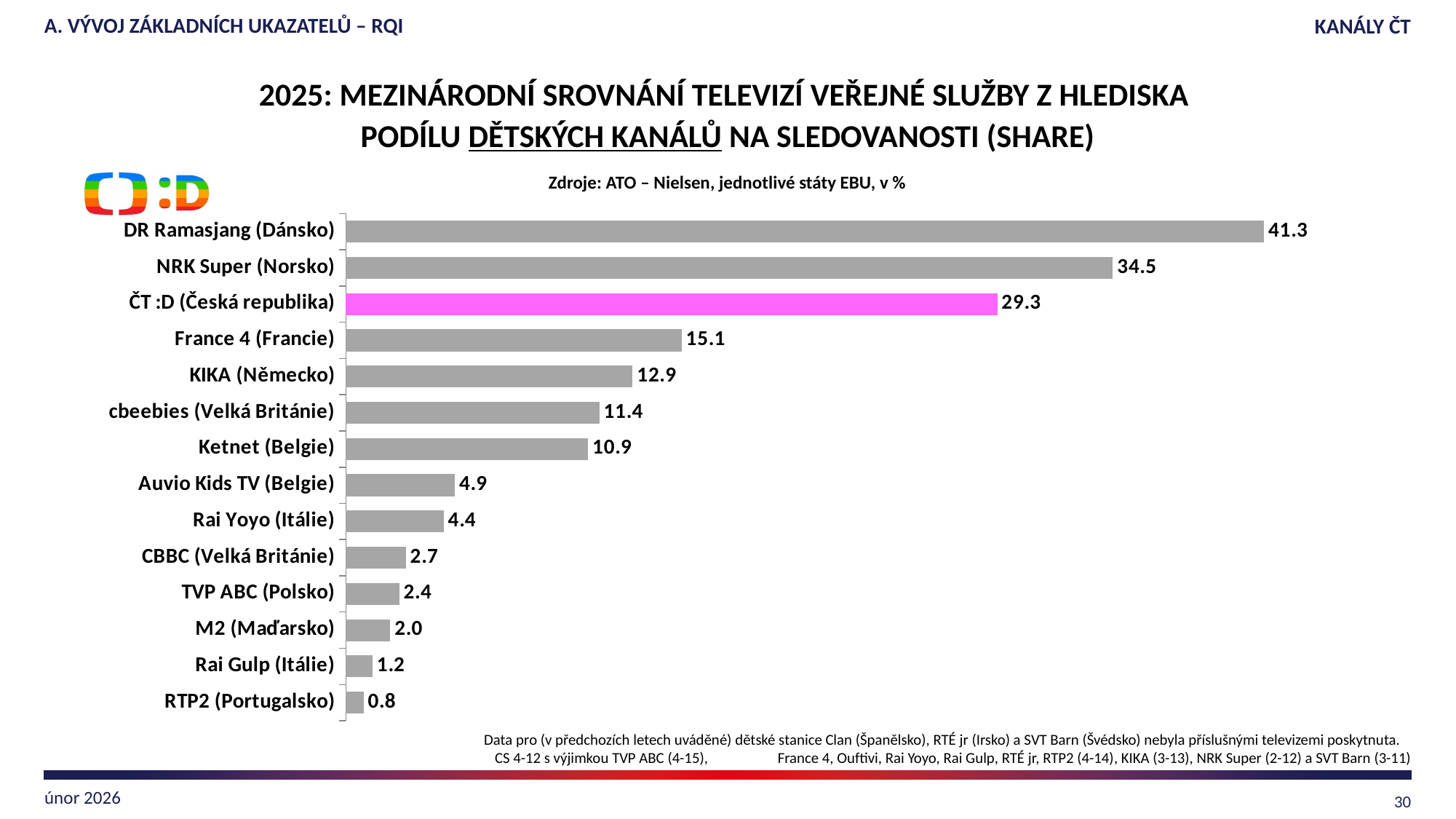
How many channels are shown in the chart? 14 What is the difference between the values for DR Ramasjang (Dánsko) and NRK Super (Norsko)? 6.8 Which has a larger value, TVP ABC (Polsko) or M2 (Maďarsko)? TVP ABC (Polsko) Which channel has the lowest value? RTP2 (Portugalsko) What is the difference between the values for ČT :D (Česká republika) and France 4 (Francie)? 14.2 What kind of chart is shown on the slide? Bar chart Which channel has the highest value? DR Ramasjang (Dánsko) What is the value for Rai Yoyo (Itálie)? 4.4 What is the value for KIKA (Německo)? 12.9 Which has a larger value, cbeebies (Velká Británie) or Ketnet (Belgie)? cbeebies (Velká Británie) What is the value for ČT :D (Česká republika)? 29.3 Which bar is highlighted in a different colour (pink) from the others? ČT :D (Česká republika)